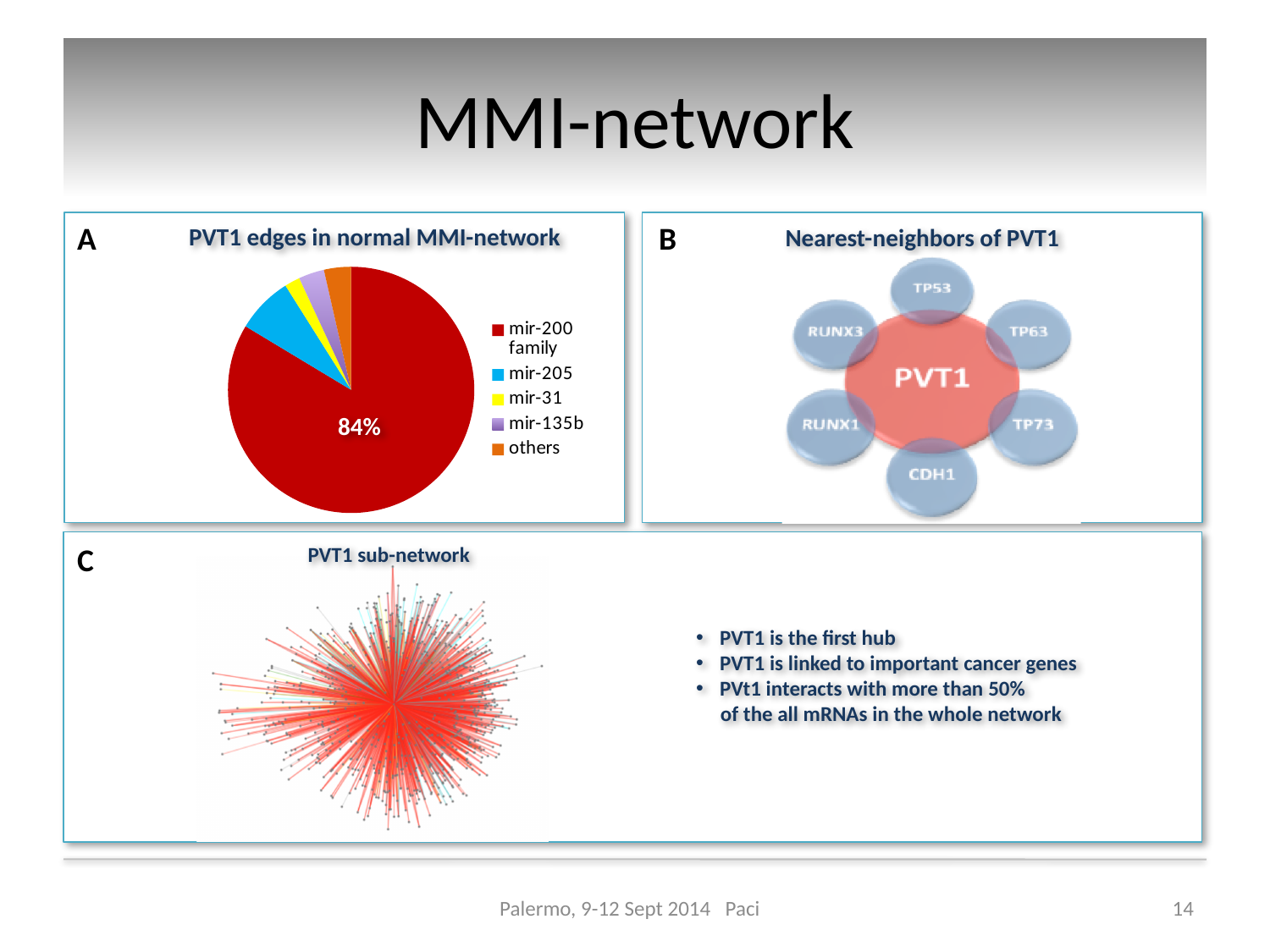
In the pie chart 'PVT1 edges in normal MMI-network', what is the value printed on the largest slice? 84% In the pie chart 'PVT1 edges in normal MMI-network', which slice is larger, mir-200 family or others? mir-200 family In the pie chart 'PVT1 edges in normal MMI-network', what share of the pie does the mir-200 family slice take? 84% In the pie chart 'PVT1 edges in normal MMI-network', which slice is larger, mir-205 or mir-31? mir-205 What is the title of the pie chart in panel A? PVT1 edges in normal MMI-network How many categories does the legend of the pie chart 'PVT1 edges in normal MMI-network' list? 5 What kind of chart is shown in panel A, 'PVT1 edges in normal MMI-network'? pie chart In the pie chart 'PVT1 edges in normal MMI-network', which category has the largest slice? mir-200 family In the pie chart 'PVT1 edges in normal MMI-network', which slice is larger, mir-200 family or mir-205? mir-200 family In the pie chart 'PVT1 edges in normal MMI-network', what colour is the mir-200 family slice? red